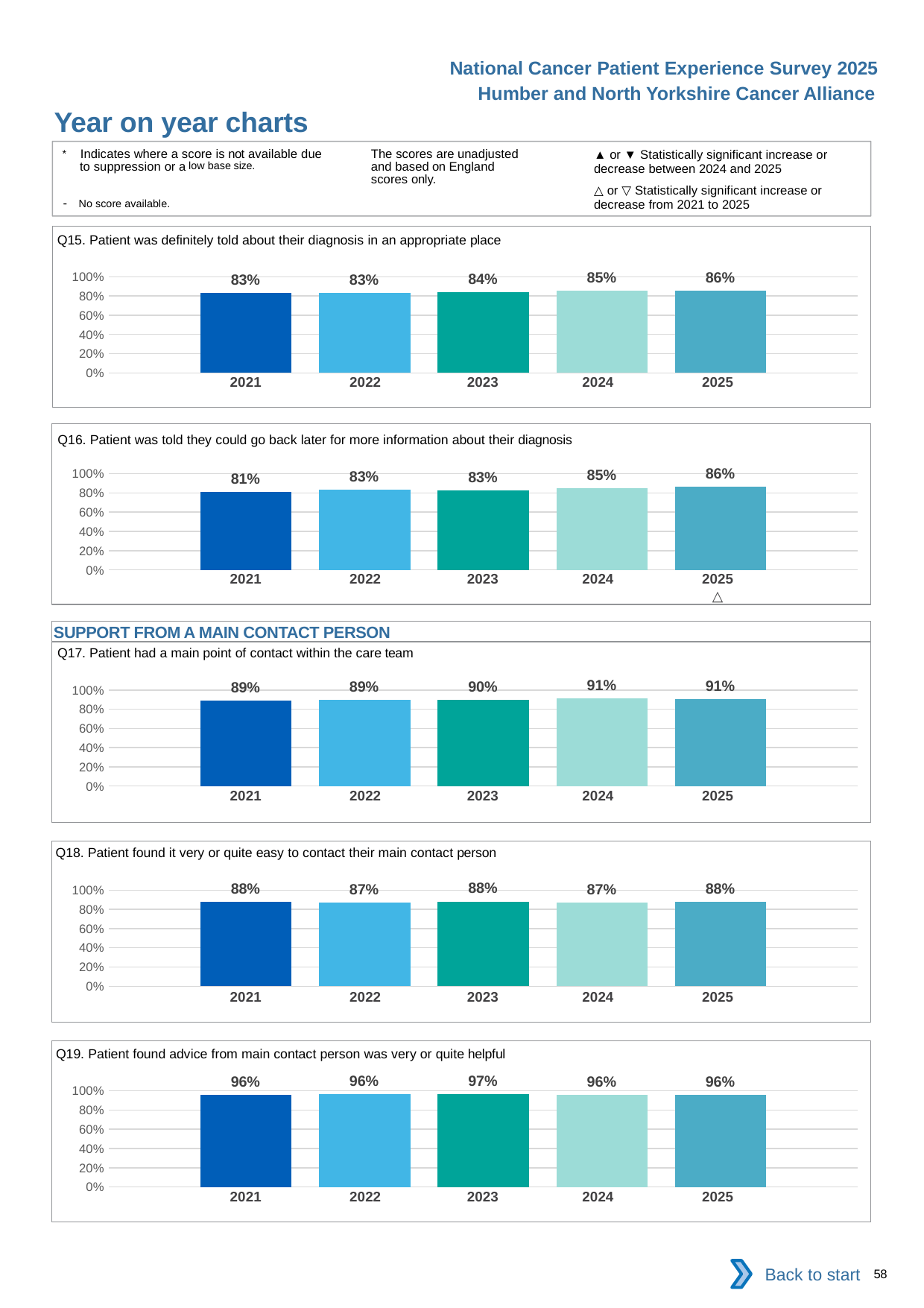
In the Q17 chart, which year has the highest value? 2024 and 2025 (both 91%) In the Q19 chart, which year has the highest value? 2023 What type of chart is used for Q15? Bar chart In the Q15 chart, what is the value for 2025? 86% In the Q15 chart, which year has the lowest value? 2021 and 2022 (both 83%) In the Q16 chart, what is the difference between the 2025 and 2021 values? 5 percentage points In the Q17 chart, what is the value for 2023? 90% In the Q16 chart, do the values rise or fall from 2021 to 2025? Rise In the Q16 chart, what is the value for 2021? 81% In the Q18 chart, what is the value for 2024? 87% How many years are shown on the x axis of the Q19 chart? 5 In the Q18 chart, is the value for 2022 larger or smaller than the value for 2023? Smaller